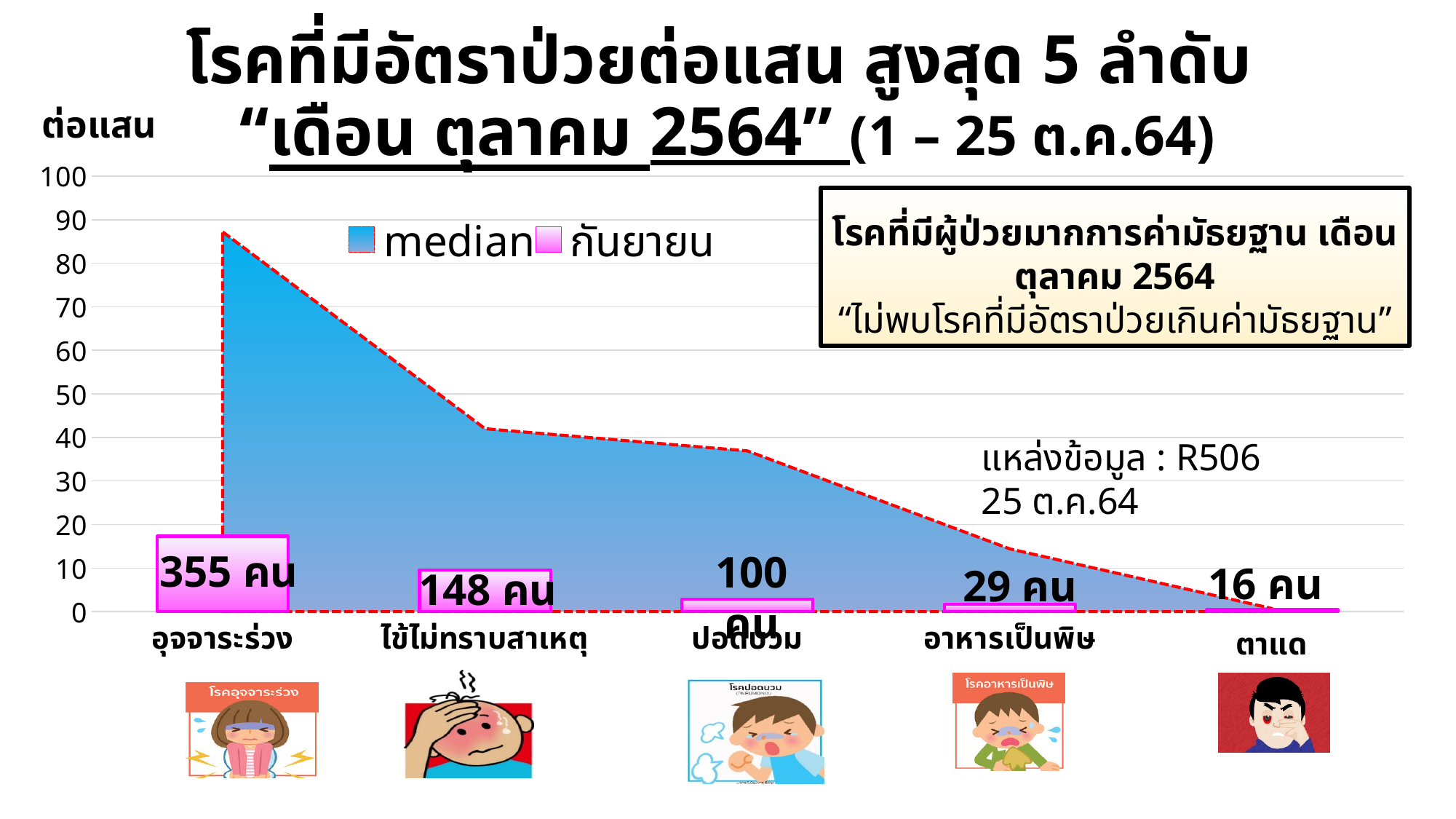
Is the median value for อาหารเป็นพิษ greater or less than 20? less Which category has the highest median value in the chart? อุจจาระร่วง Does the median series rise or fall from left to right across the categories? fall What data label is printed on the bar for ตาแดง? 16 คน Is the median value for ปอดบวม greater or less than 30? greater Which category has the lowest median value in the chart? ตาแดง How many disease categories are shown on the x axis of the chart? 5 Is the median value for อุจจาระร่วง greater or less than 80? greater What data label is printed on the bar for อุจจาระร่วง? 355 คน How many series does the chart legend list? 2 Which is larger, the median value for อุจจาระร่วง or for ไข้ไม่ทราบสาเหตุ? อุจจาระร่วง What are the two entries in the chart legend? median and กันยายน